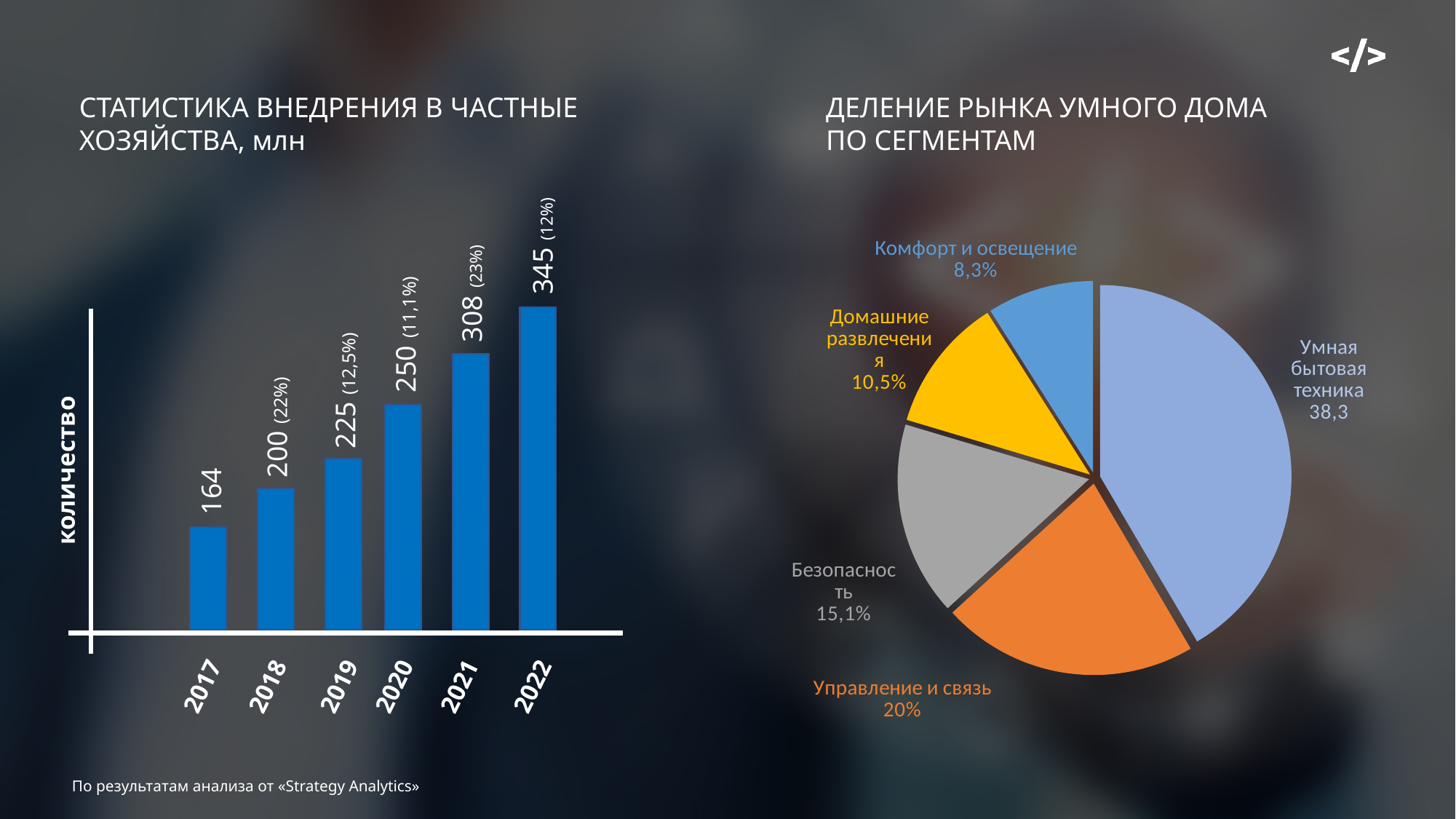
In the bar chart on the left, what is the value for 2021? 308 In the bar chart on the left, what percentage growth is shown in parentheses next to the 2021 bar? 23% In the bar chart on the left (СТАТИСТИКА ВНЕДРЕНИЯ В ЧАСТНЫЕ ХОЗЯЙСТВА, млн), what is the value for 2017? 164 In the pie chart on the right, which segment has the largest share? Умная бытовая техника In the pie chart on the right, how many segments are there? 5 In the bar chart on the left, which year has the lowest value? 2017 In the bar chart on the left, what is the difference between the values for 2022 and 2021? 37 In the pie chart on the right, what is the value shown for Безопасность? 15,1% What kind of chart is the one on the right (ДЕЛЕНИЕ РЫНКА УМНОГО ДОМА ПО СЕГМЕНТАМ)? pie chart In the bar chart on the left, how many years are shown on the x axis? 6 In the bar chart on the left, which year has the highest value? 2022 In the bar chart on the left, do the values rise or fall from 2017 to 2022? rise